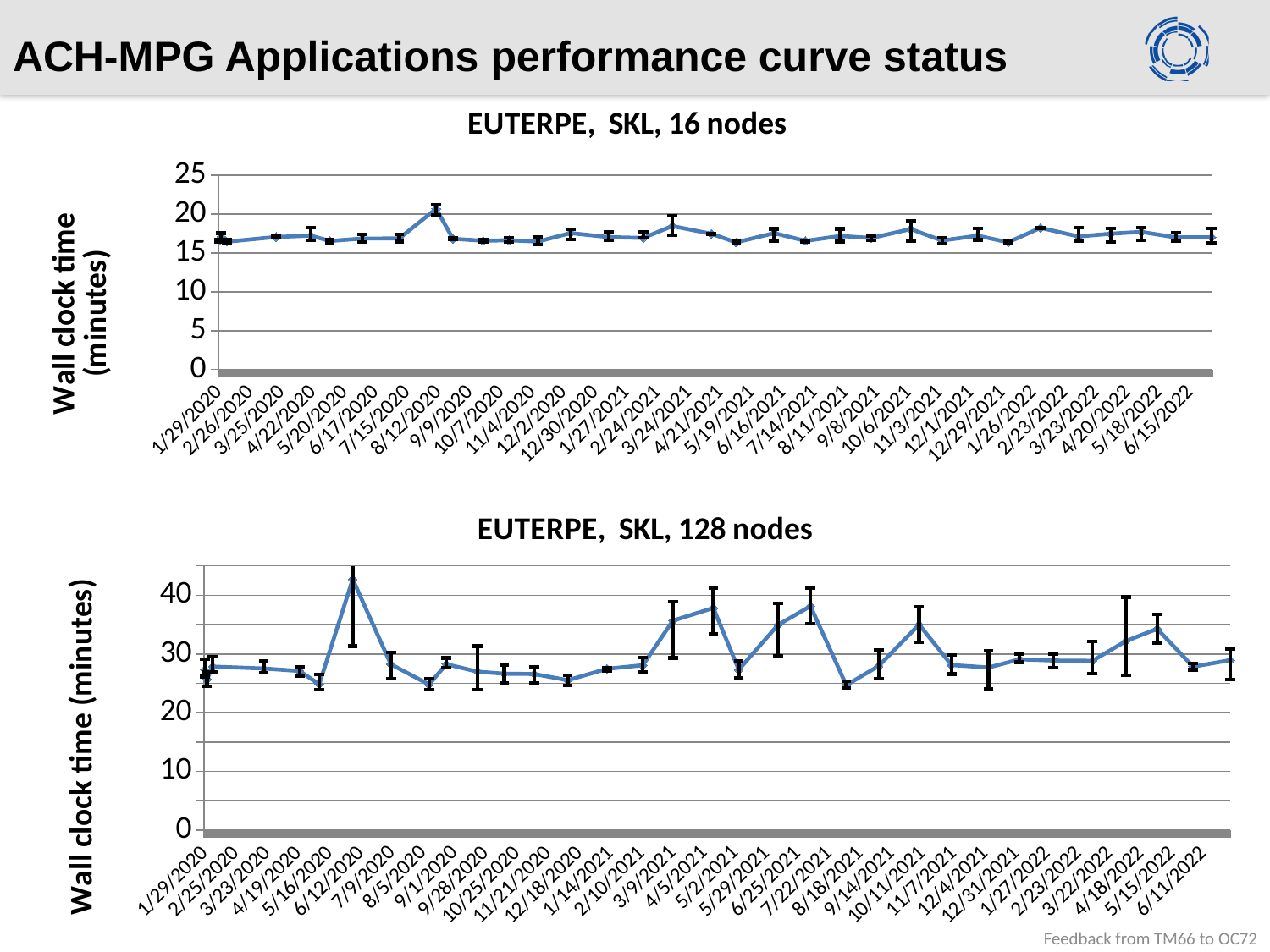
In the 'EUTERPE, SKL, 16 nodes' chart, is the value for 1/29/2020 greater or less than 20? less In the 'EUTERPE, SKL, 128 nodes' chart, is the value for 6/12/2020 greater or less than 40? greater In the 'EUTERPE, SKL, 128 nodes' chart, which date has the highest wall clock time? 6/12/2020 In the 'EUTERPE, SKL, 128 nodes' chart, is the value for 4/5/2021 greater or less than 30? greater In the 'EUTERPE, SKL, 16 nodes' chart, which date has the highest wall clock time? 8/12/2020 In the 'EUTERPE, SKL, 16 nodes' chart, which is larger, the value for 8/12/2020 or the value for 1/29/2020? 8/12/2020 In the 'EUTERPE, SKL, 128 nodes' chart, which is larger, the value for 6/12/2020 or the value for 8/5/2020? 6/12/2020 What kind of chart is the 'EUTERPE, SKL, 128 nodes' chart? line chart What kind of chart is the 'EUTERPE, SKL, 16 nodes' chart? line chart What is the y-axis label of the 'EUTERPE, SKL, 128 nodes' chart? Wall clock time (minutes)